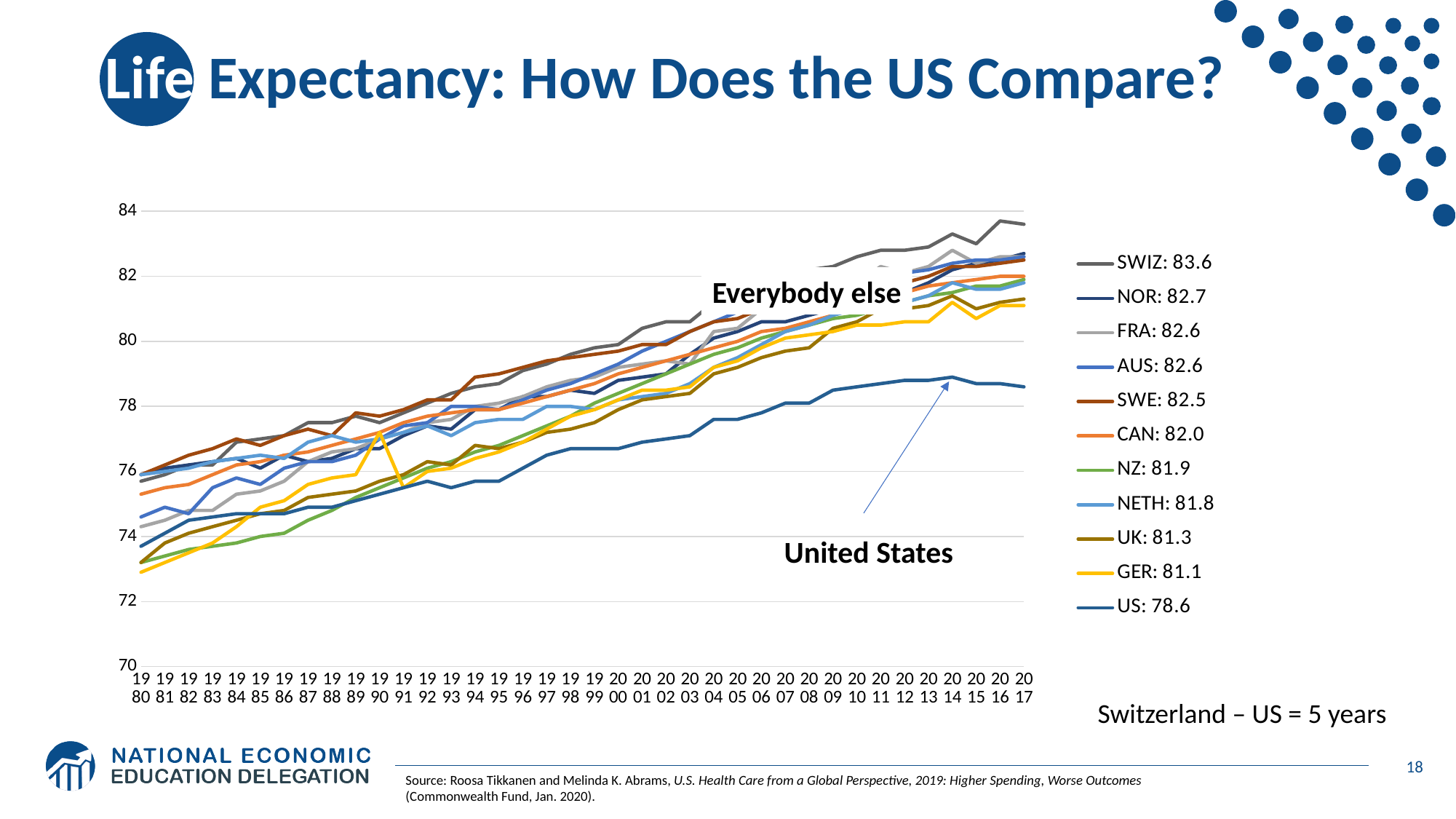
What kind of chart is shown on the slide? line chart What life expectancy value is shown for US in the legend? 78.6 Which country has the lowest life expectancy value in the legend? US Is the US line in 2017 greater or less than 80? less Which has the larger legend value, CAN or NZ? CAN What is the difference between the NOR value and the US value shown in the legend? 4.1 What life expectancy value is shown for SWIZ in the legend? 83.6 What value is shown for UK in the legend? 81.3 What is the difference between the SWIZ value and the US value shown in the legend? 5 Which country has the highest life expectancy value in the legend? SWIZ Do the life expectancy lines generally rise or fall from 1980 to 2017? rise How many series does the legend list? 11